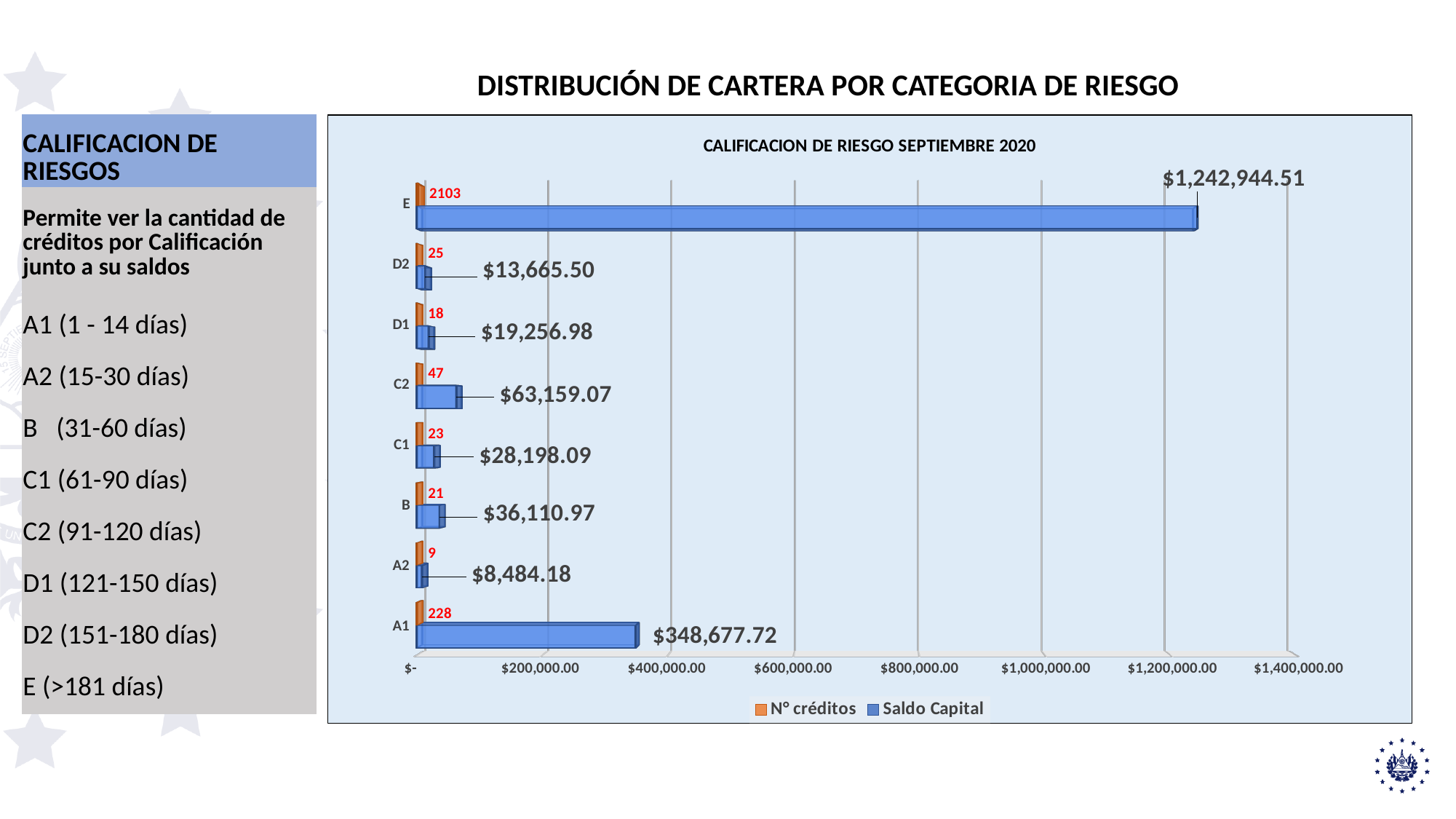
Which category has the highest Saldo Capital? E Which category has the lowest Saldo Capital? A2 What is the Saldo Capital for category E? $1,242,944.51 How many more N° créditos does category E have than category A1? 1875 What is the difference in Saldo Capital between category E and category A1? $894,266.79 How many series does the legend list? 2 Which category has the fewest N° créditos? A2 How many N° créditos are shown for category A1? 228 How many categories are shown on the chart? 8 How many N° créditos are shown for category D1? 18 What is the Saldo Capital for category C2? $63,159.07 Which has a larger Saldo Capital, category B or category C1? B